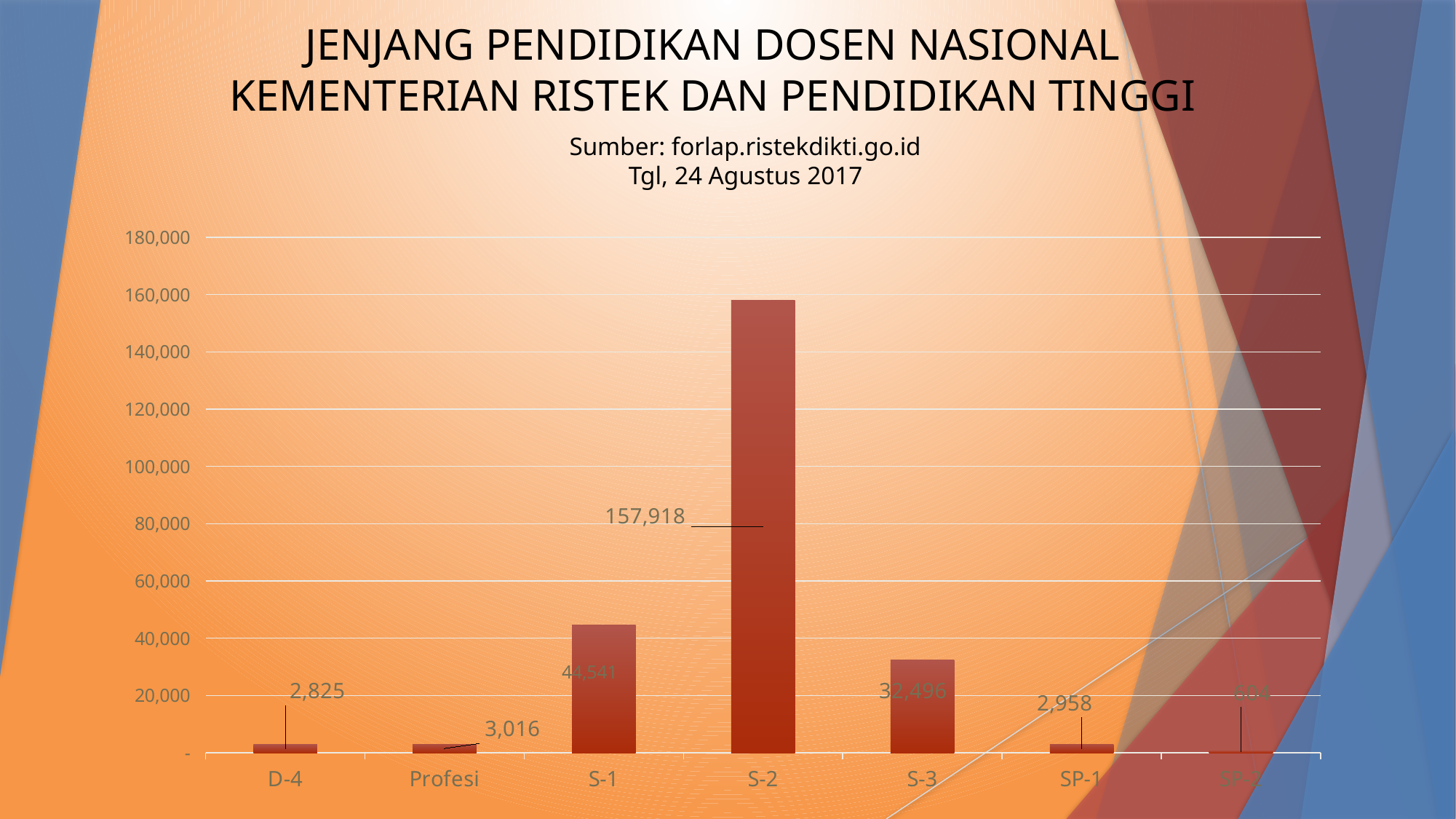
Which is larger, the value for D-4 or the value for SP-1? SP-1 What kind of chart is shown on the slide? bar chart What is the difference between the values for S-1 and S-3? 12,045 What is the value for D-4? 2,825 What is the difference between the values for S-2 and S-1? 113,377 What is the value for S-3? 32,496 What is the value for S-1? 44,541 What is the value for Profesi? 3,016 Is the value for S-2 greater or less than 140,000? greater What is the value for SP-1? 2,958 Which category has the highest value? S-2 What is the value for S-2? 157,918